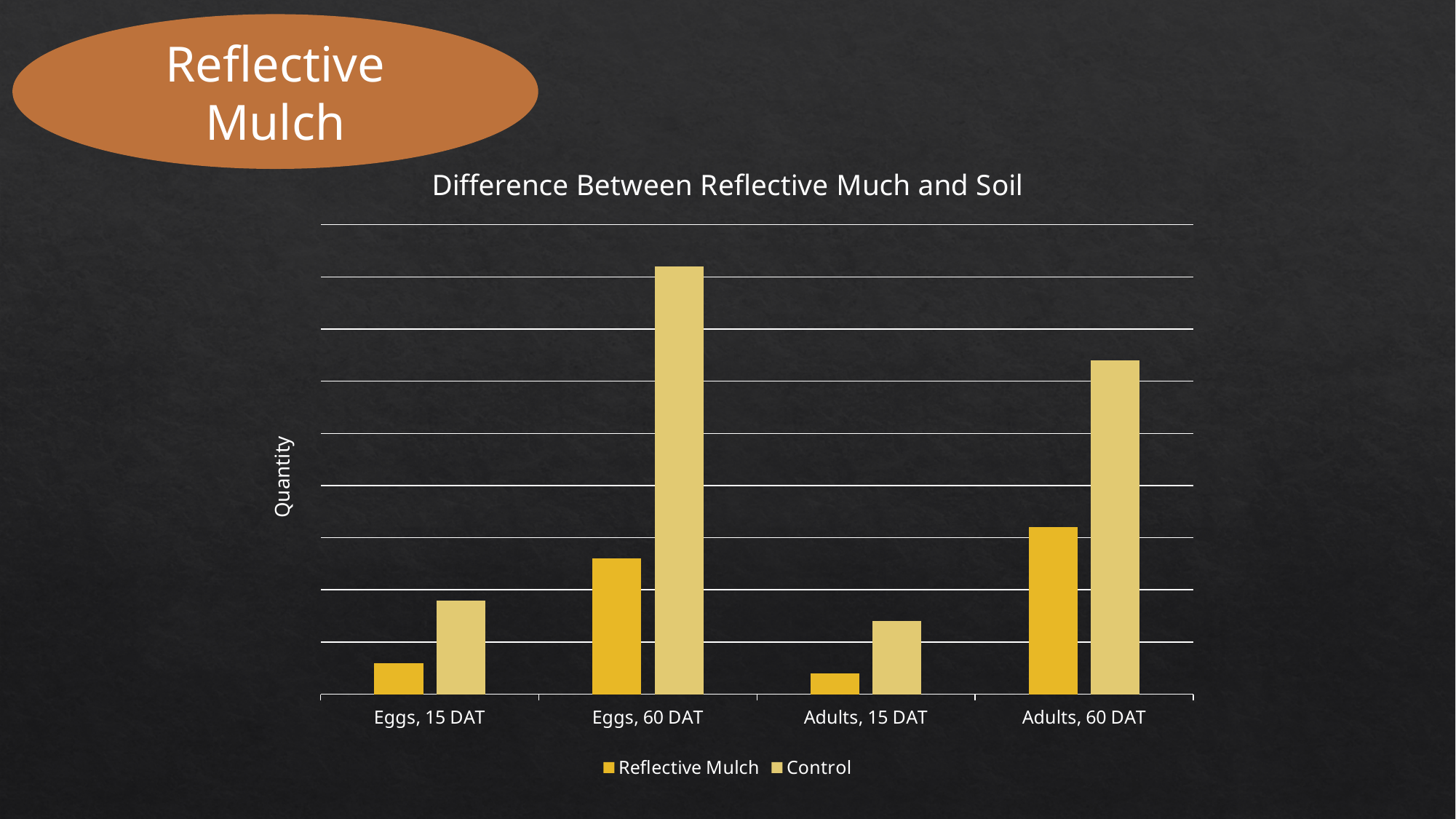
What kind of chart is shown on the slide? bar chart Is the Reflective Mulch value larger for Eggs, 60 DAT or for Adults, 60 DAT? Adults, 60 DAT Which category has the highest Control value? Eggs, 60 DAT What is the label on the vertical axis of the chart? Quantity How many series does the chart's legend list? 2 Which bar is the tallest in the whole chart? Control, Eggs, 60 DAT Is the Control value larger for Eggs, 60 DAT or for Adults, 60 DAT? Eggs, 60 DAT Which category has the highest Reflective Mulch value? Adults, 60 DAT What is the title of the chart? Difference Between Reflective Much and Soil For Adults, 15 DAT, which series has the larger value, Reflective Mulch or Control? Control Which category has the lowest Reflective Mulch value? Adults, 15 DAT How many categories are shown on the x axis of the chart? 4